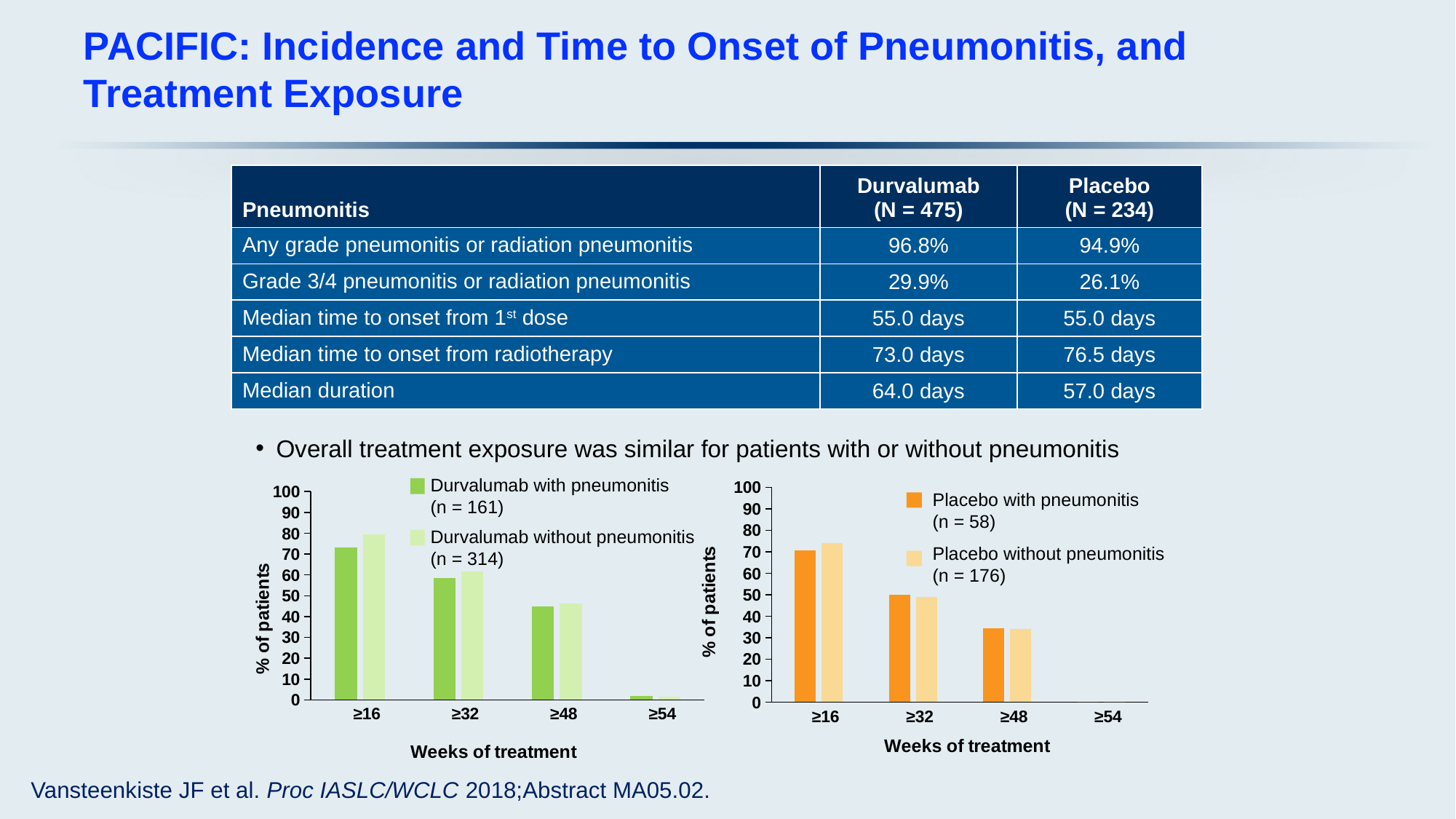
In the right chart (Placebo), is the value for Placebo with pneumonitis at ≥48 weeks greater or less than 40? less In the right chart (Placebo), is the value for Placebo with pneumonitis at ≥16 weeks greater or less than 60? greater In the left chart (Durvalumab), is the value for Durvalumab with pneumonitis at ≥16 weeks greater or less than 60? greater How many series does the legend of the right chart (Placebo) list? 2 What kind of chart is the left chart (Durvalumab)? bar chart In the left chart (Durvalumab), at ≥16 weeks, which series has the larger value: Durvalumab with pneumonitis or Durvalumab without pneumonitis? Durvalumab without pneumonitis In the right chart (Placebo), what is the n value given in the legend for Placebo without pneumonitis? n = 176 In the right chart (Placebo), do the values for Placebo with pneumonitis rise or fall as weeks of treatment increase along the x axis? fall How many weeks-of-treatment categories are shown on the x axis of the left chart (Durvalumab)? 4 In the left chart (Durvalumab), at which weeks-of-treatment category is the value for Durvalumab with pneumonitis highest? ≥16